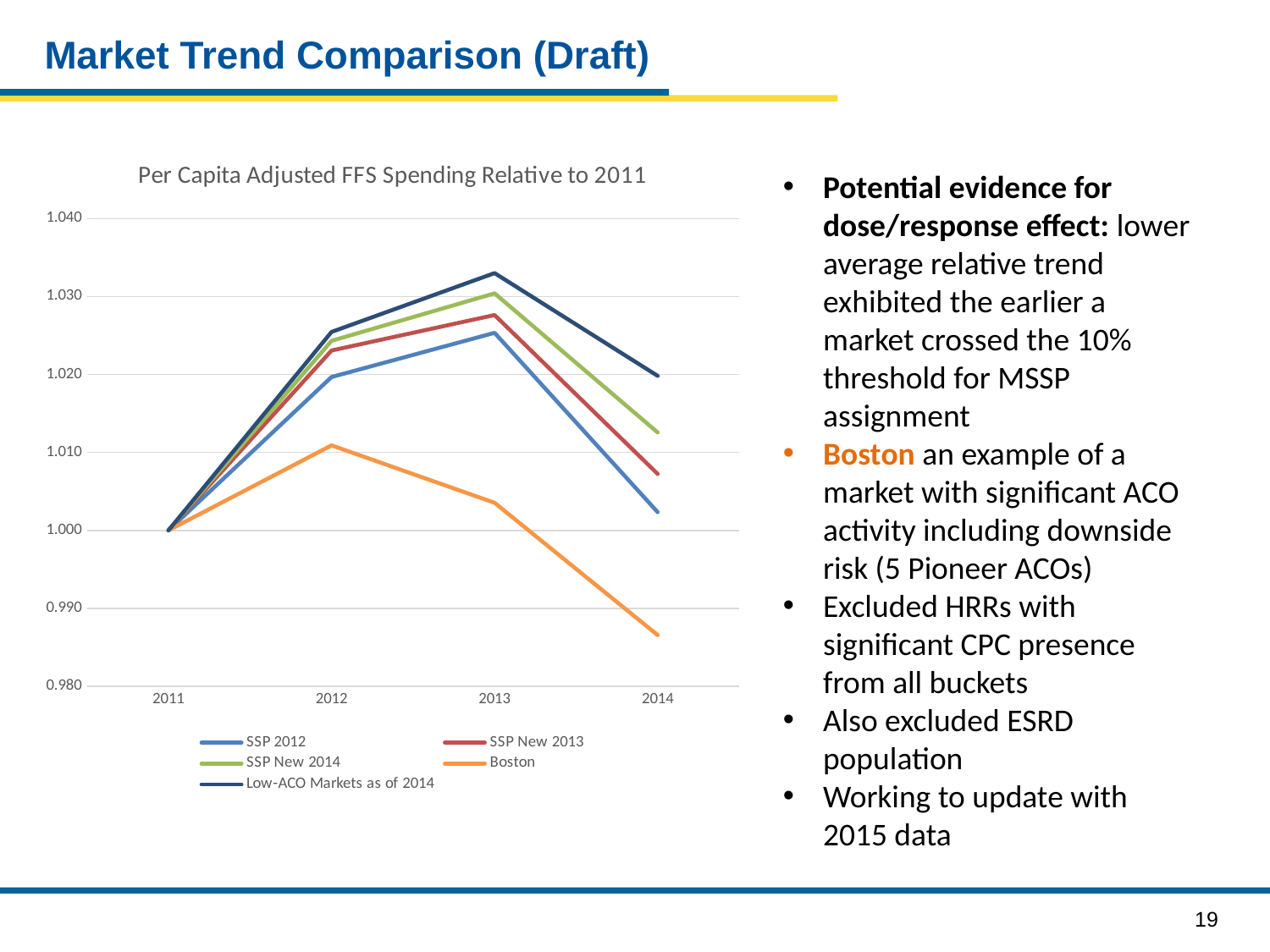
How many years are plotted along the x axis? 4 Which series has the lowest value in 2014? Boston Is the value for Low-ACO Markets as of 2014 in 2013 greater or less than 1.030? greater What is the value for Boston in 2011? 1.000 Which series has the highest value in 2013? Low-ACO Markets as of 2014 In 2014, which is larger: the value for SSP 2012 or the value for Boston? SSP 2012 Is the value for Boston in 2014 greater or less than 0.990? less What kind of chart is shown on the slide? line chart Is the value for SSP New 2013 in 2014 greater or less than 1.010? less How many series does the chart's legend list? 5 Does the Boston line rise or fall from 2012 to 2014? fall What is the title of the chart? Per Capita Adjusted FFS Spending Relative to 2011